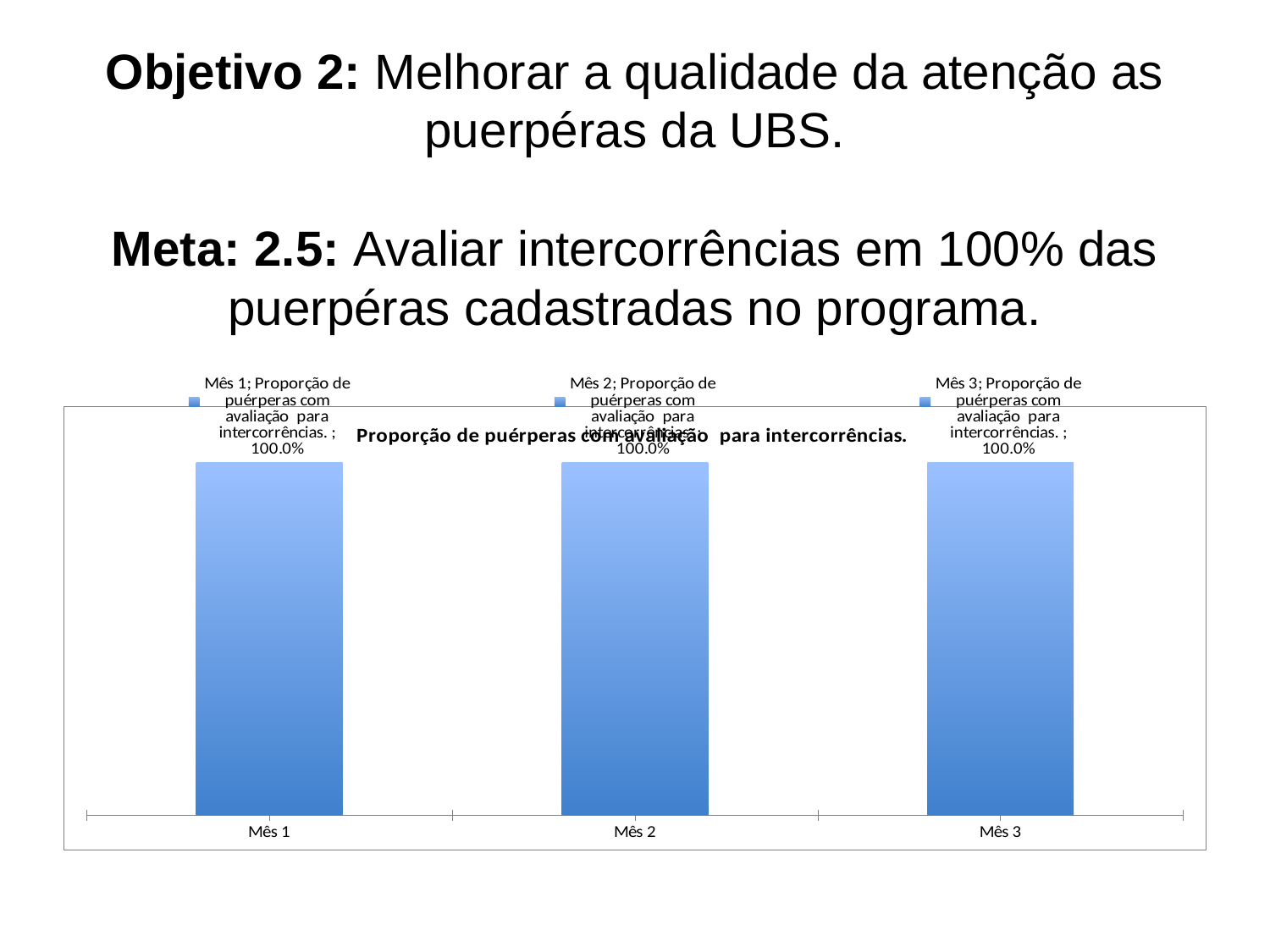
What is the title of the chart? Proporção de puérperas com avaliação para intercorrências. What is the value for Mês 3 in the chart? 100.0% What kind of chart is shown on the slide? Bar chart How many categories are shown on the x axis of the chart? 3 What is the value for Mês 2 in the chart? 100.0% Is the value for Mês 2 equal to 100.0%? Yes What is the label of the first category on the x axis? Mês 1 What is the value for Mês 1 in the chart? 100.0% Do the values rise, fall, or stay the same from Mês 1 to Mês 3? Stay the same What is the difference between the values for Mês 1 and Mês 3? 0.0%